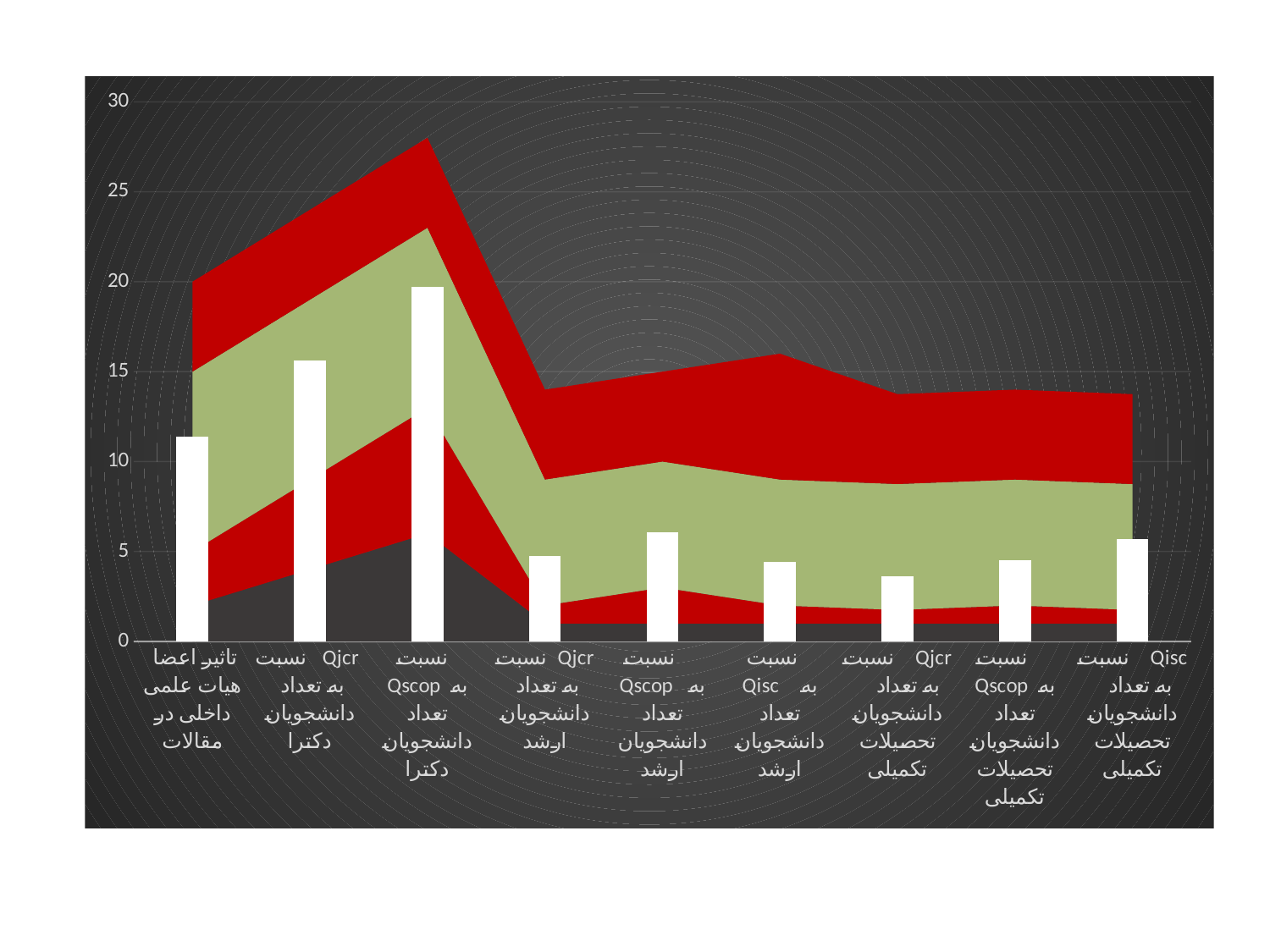
What is the highest value shown on the vertical axis? 30 Is the white bar for نسبت Qscop به تعداد دانشجویان ارشد greater or less than 5? greater Is the white bar for نسبت Qscop به تعداد دانشجویان دکترا greater or less than 15? greater Which category has the tallest white bar? نسبت Qscop به تعداد دانشجویان دکترا Which category has the shortest white bar? نسبت Qjcr به تعداد دانشجویان تحصیلات تکمیلی How many categories are shown on the x axis? 9 What colour are the bars in the chart? White Which white bar is taller: نسبت Qjcr به تعداد دانشجویان دکترا or نسبت Qscop به تعداد دانشجویان دکترا? نسبت Qscop به تعداد دانشجویان دکترا Is the white bar for تاثیر اعضا هیات علمی داخلی در مقالات greater or less than 10? greater Which white bar is taller: نسبت Qscop به تعداد دانشجویان ارشد or نسبت Qisc به تعداد دانشجویان ارشد? نسبت Qscop به تعداد دانشجویان ارشد